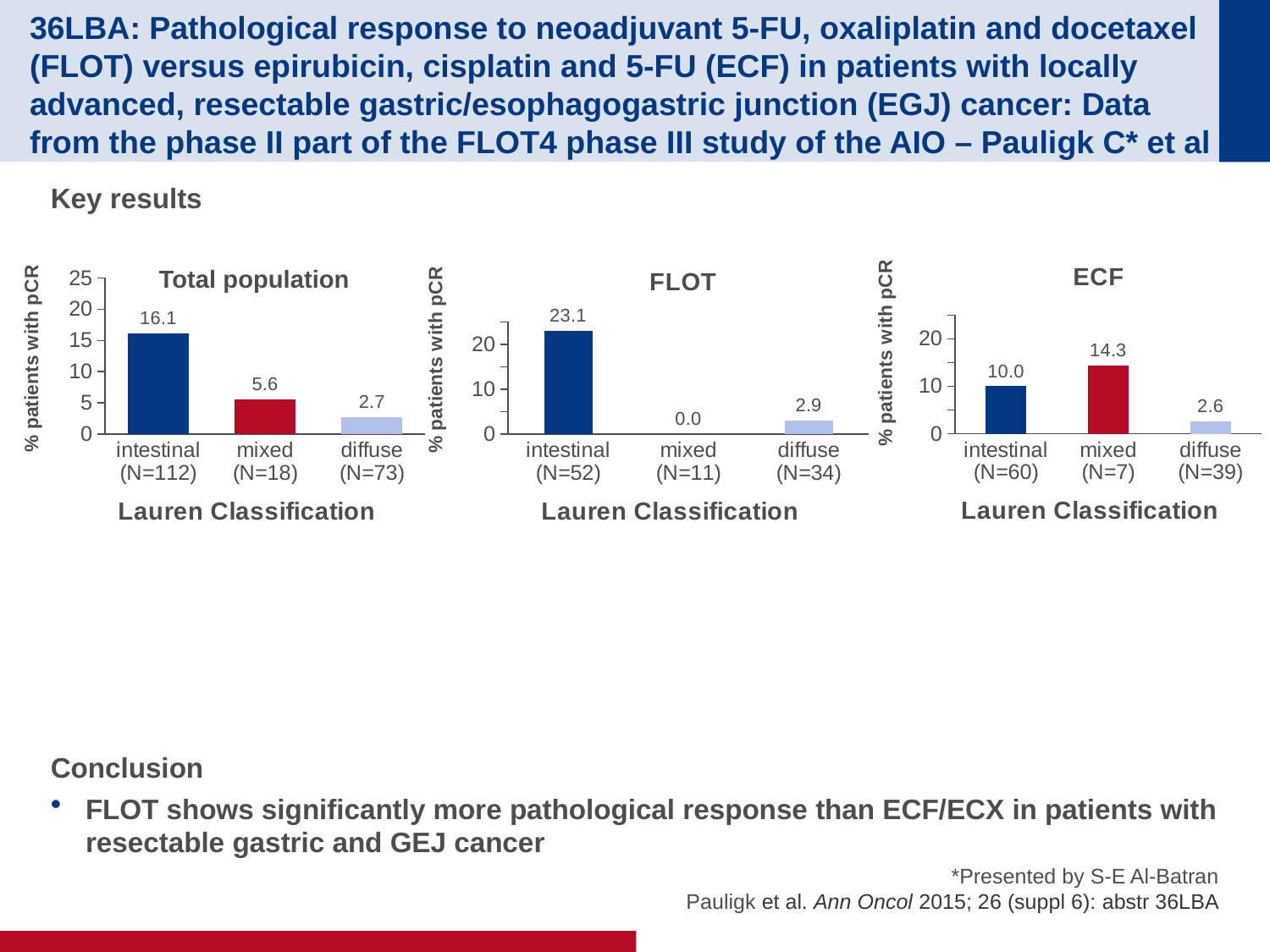
How many categories are shown in the ECF chart? 3 In the FLOT chart, what is the difference between the intestinal and diffuse values? 20.2 In the Total population chart, what is the difference between the intestinal and mixed values? 10.5 What kind of chart is the Total population chart? bar chart In the ECF chart, which is larger, the value for intestinal or the value for mixed? mixed In the FLOT chart, is the value for intestinal greater or less than 20? greater What is the x-axis title of the ECF chart? Lauren Classification In the Total population chart, what is the value for intestinal (N=112)? 16.1 In the FLOT chart, which Lauren classification has the highest % of patients with pCR? intestinal (N=52) In the ECF chart, what is the value for diffuse (N=39)? 2.6 In the FLOT chart, what is the value for mixed (N=11)? 0.0 In the ECF chart, which Lauren classification has the lowest % of patients with pCR? diffuse (N=39)